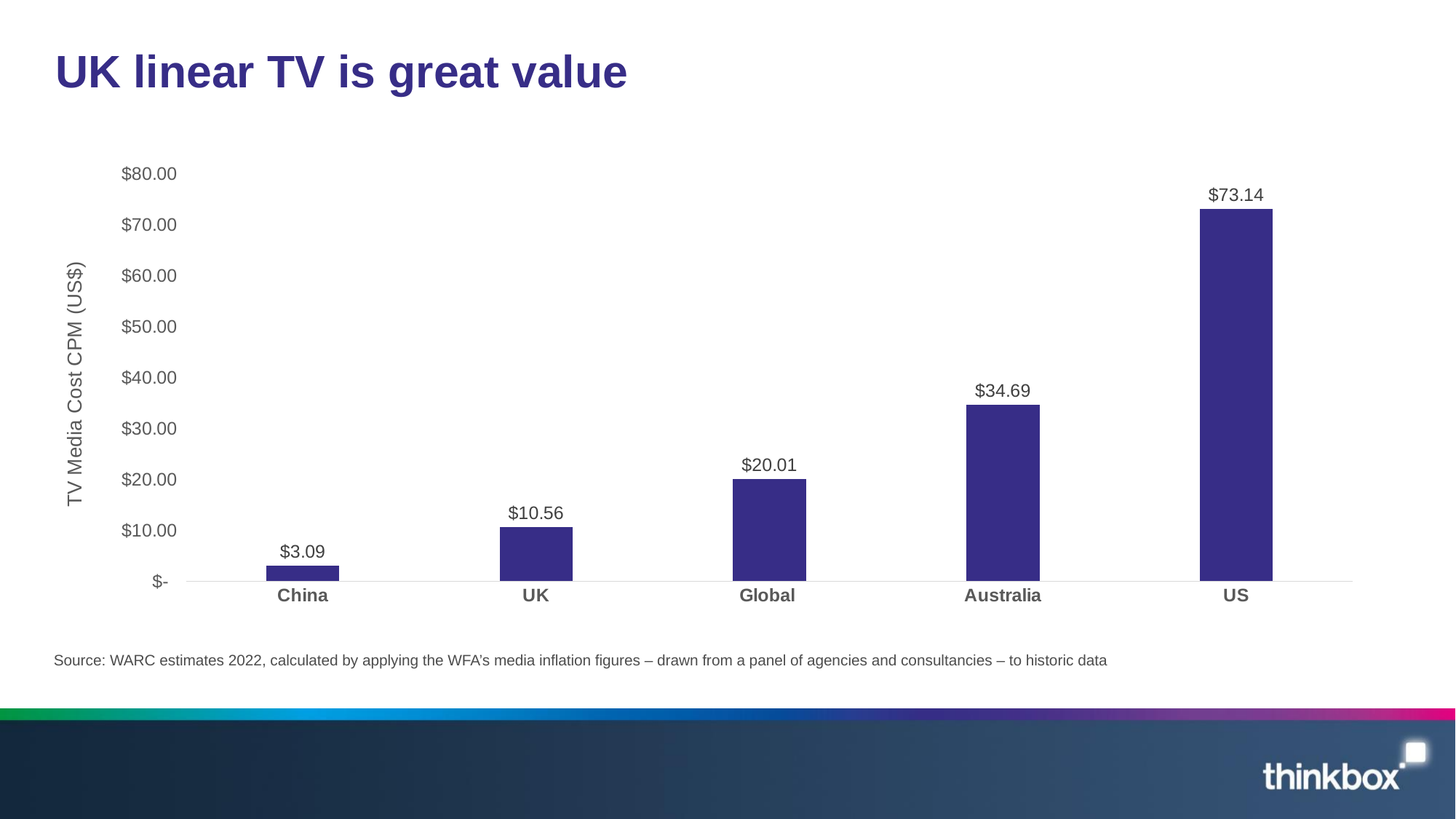
What is the difference between the US and UK TV media cost CPM? $62.58 Which country or region has the lowest TV media cost CPM? China Which has a higher TV media cost CPM, Australia or Global? Australia What kind of chart is shown on the slide? Bar chart How many countries or regions are shown in the chart? 5 What is the TV media cost CPM for Australia? $34.69 Is the value for the US greater or less than $70.00? greater What is the label on the vertical axis of the chart? TV Media Cost CPM (US$) What is the difference between the Global and UK TV media cost CPM? $9.45 What is the TV media cost CPM for the UK? $10.56 What is the TV media cost CPM for China? $3.09 Which country or region has the highest TV media cost CPM? US